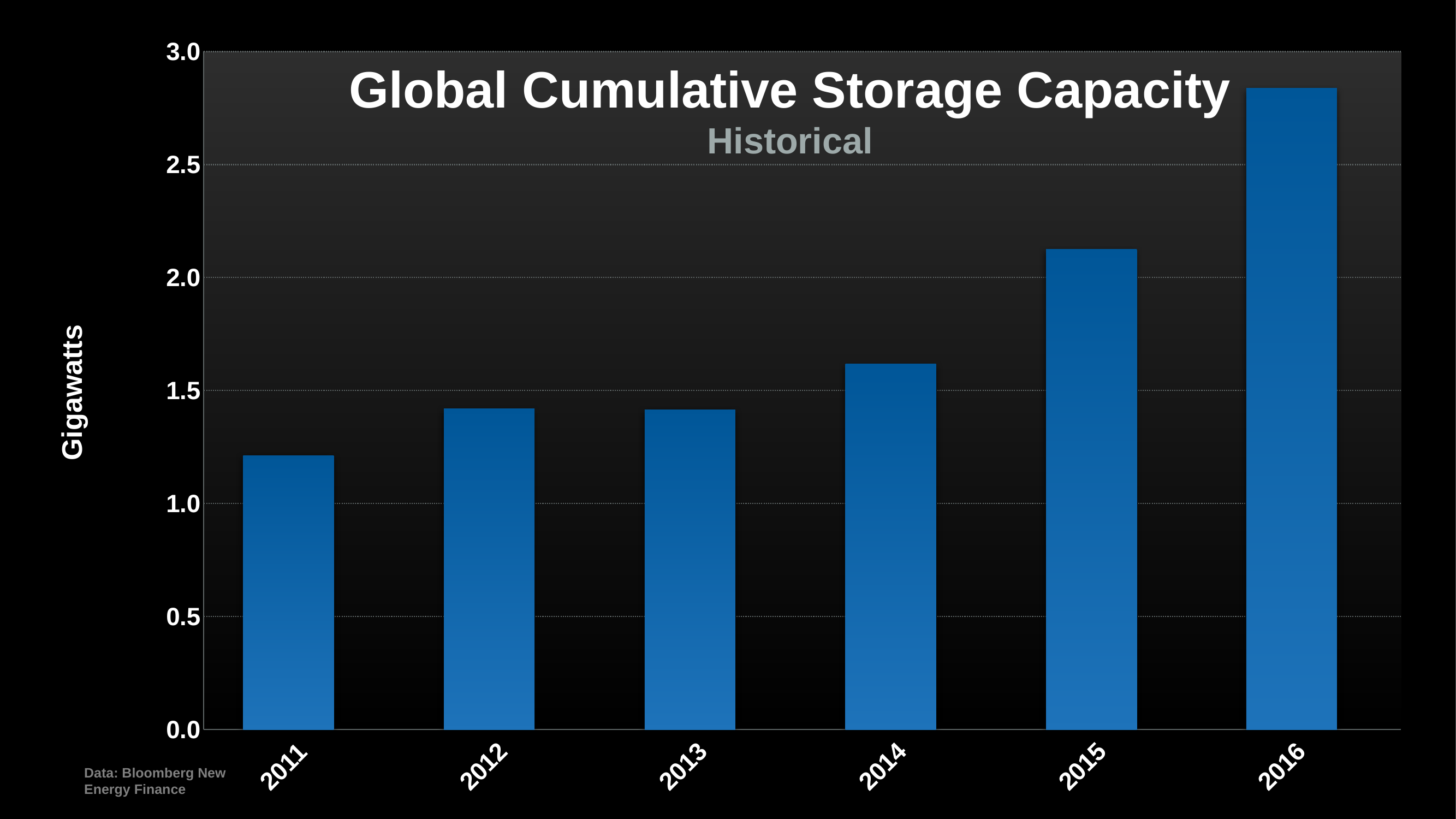
Which is larger, the value for 2011 or the value for 2012? 2012 Is the value for 2015 greater or less than 2.0 gigawatts? greater How many years are plotted on the x axis? 6 Is the value for 2014 greater or less than 1.5 gigawatts? greater Which is larger, the value for 2015 or the value for 2016? 2016 Which year has the highest global cumulative storage capacity? 2016 Is the value for 2012 greater or less than 1.5 gigawatts? less Do the values generally rise or fall from 2011 to 2016? rise What is the label on the y axis? Gigawatts Which year has the lowest global cumulative storage capacity? 2011 What kind of chart is shown on the slide? bar chart